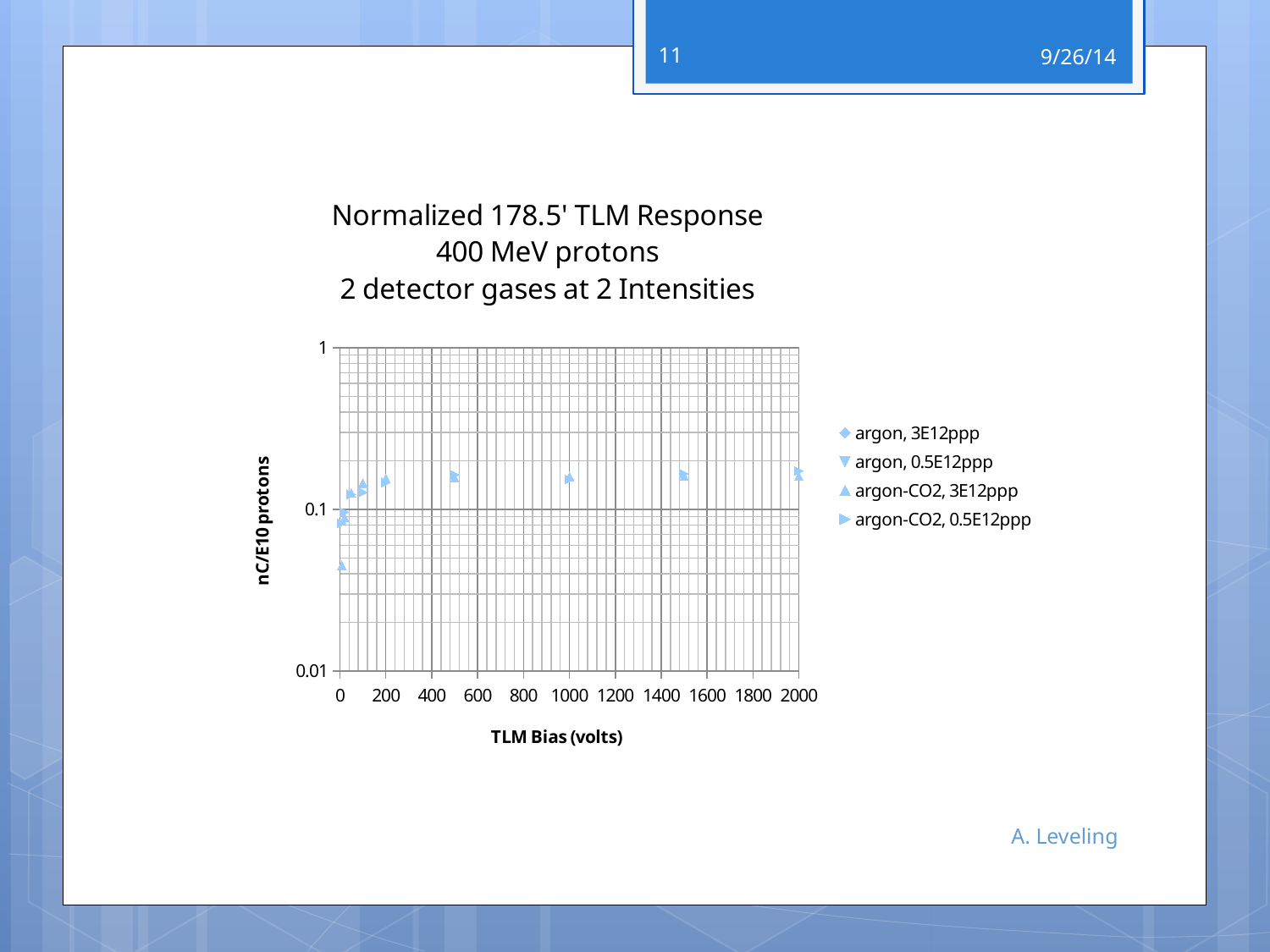
How many series does the legend list? 4 Is the value for the points at 2000 volts greater or less than 0.1? greater What kind of chart is shown on the slide? scatter chart What is the lowest tick value shown on the y axis? 0.01 What is the label of the y axis? nC/E10 protons Is the lowest plotted point, near 0 volts, greater or less than 0.1? less Is the value for the points at 1500 volts greater or less than 0.1? greater Do the plotted values rise or fall as TLM bias increases from 0 to 200 volts? rise What is the label of the x axis? TLM Bias (volts)